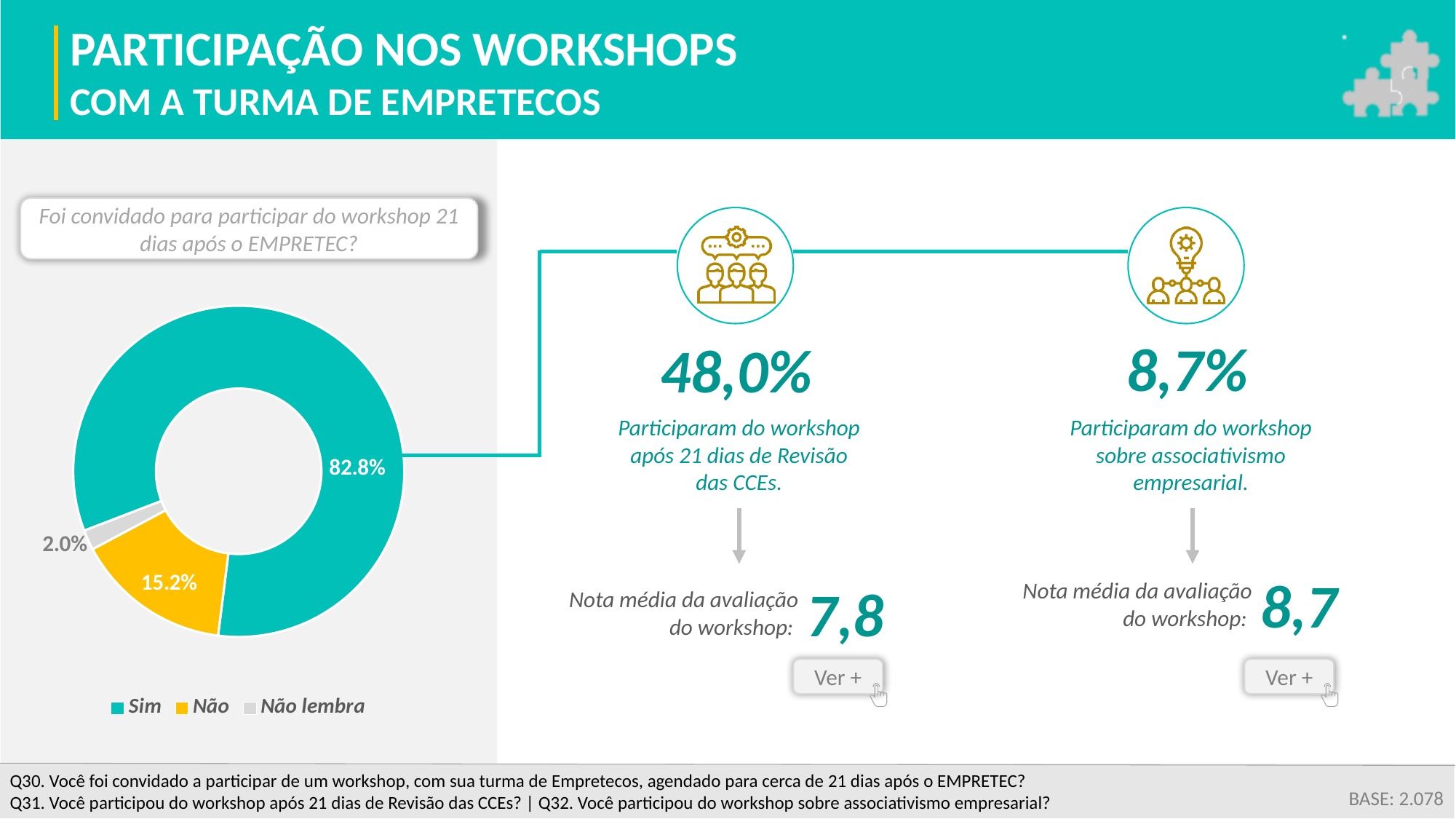
What kind of chart is shown on the slide? Pie chart (donut) What question does the donut chart answer, according to the label above it? Foi convidado para participar do workshop 21 dias após o EMPRETEC? What colour is the "Não" slice in the donut chart? Yellow/orange How many slices does the donut chart have? 3 What share of respondents answered "Não lembra" in the donut chart? 2.0% What share of respondents answered "Não" in the donut chart? 15.2% Which category has the largest slice in the donut chart? Sim Which is larger in the donut chart, the "Não" slice or the "Não lembra" slice? Não Which category has the smallest slice in the donut chart? Não lembra What is the difference in percentage points between the "Sim" and "Não" slices? 67.6 How many categories does the legend of the donut chart list? 3 What share of respondents answered "Sim" in the donut chart? 82.8%